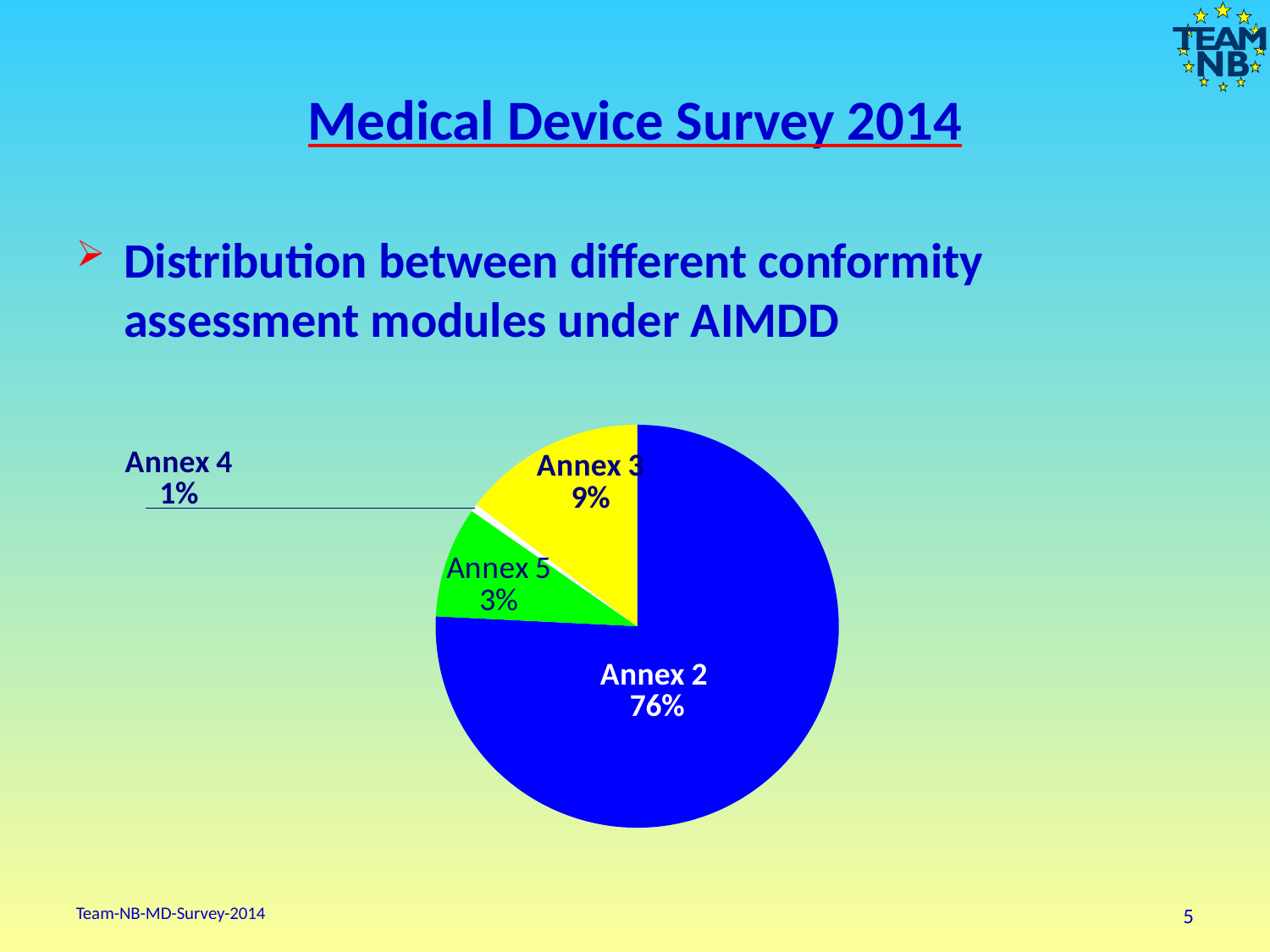
What is the combined share of Annex 3, Annex 4 and Annex 5? 13% Which annex has the smallest slice of the pie? Annex 4 What share of the pie does Annex 4 have? 1% Which is larger, the share for Annex 3 or the share for Annex 5? Annex 3 What kind of chart is shown on the slide? pie chart What share of the pie does Annex 2 have? 76% What share of the pie does Annex 5 have? 3% What colour is the Annex 5 slice? green What is the difference in percentage points between Annex 2 and Annex 3? 67 How many slices does the pie chart have? 4 Which annex has the largest slice of the pie? Annex 2